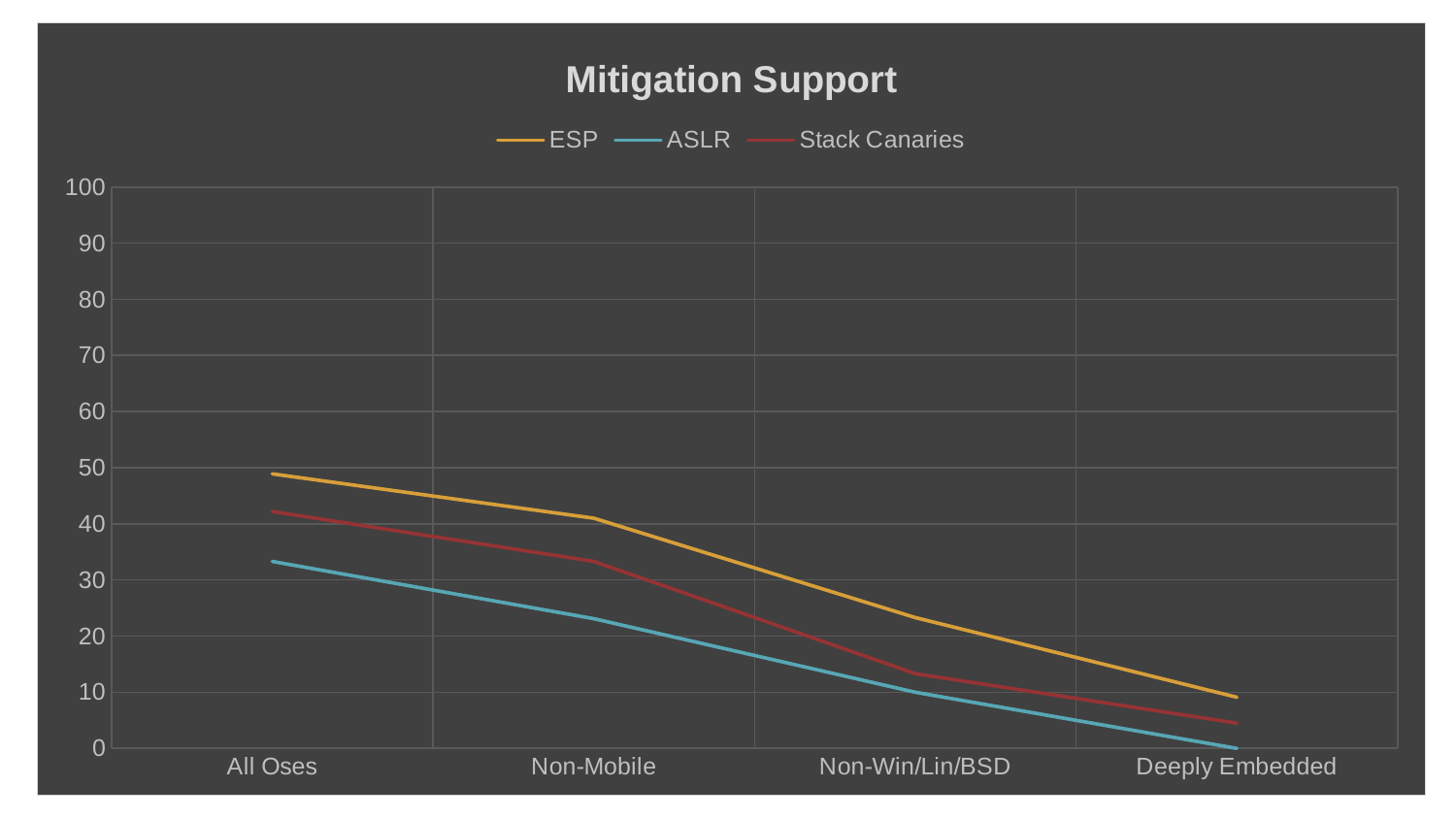
What is the title of the chart? Mitigation Support Which is larger at Deeply Embedded, the ESP value or the Stack Canaries value? ESP Do the ESP values rise or fall from All Oses to Deeply Embedded? fall Is the ESP value for All Oses greater or less than 40? greater What kind of chart is shown on the slide? line chart Which series has the lowest value at All Oses? ASLR How many categories are shown on the x axis? 4 Which series has the highest value at Non-Win/Lin/BSD? ESP How many series does the legend list? 3 Is the ASLR value for Non-Win/Lin/BSD greater or less than 20? less Which series is drawn in orange? ESP Is the Stack Canaries value for Non-Mobile greater or less than 30? greater